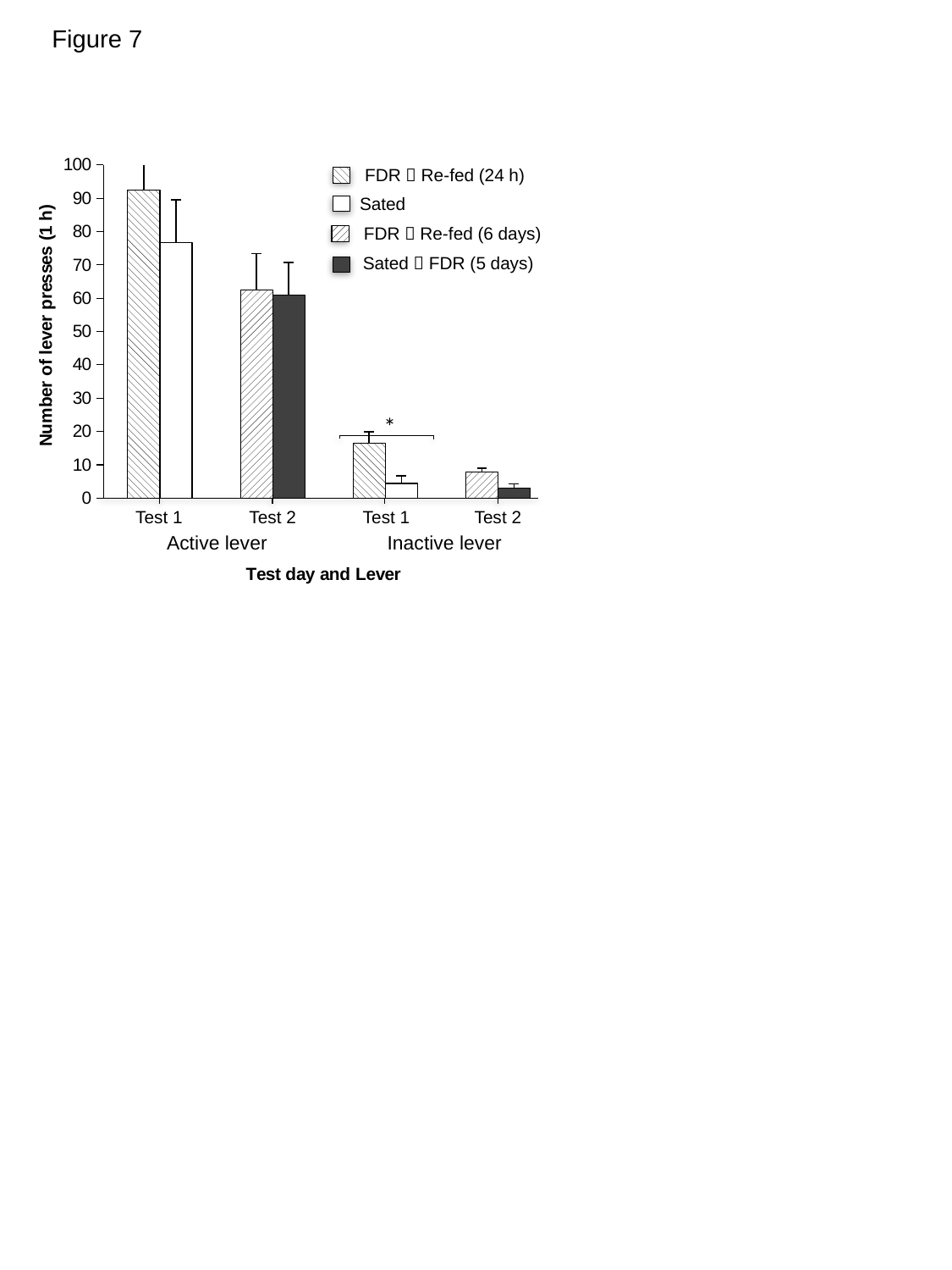
Is the value for Sated on the Active lever at Test 1 greater or less than 70? greater Is the value for FDR → Re-fed (24 h) on the Active lever at Test 1 greater or less than 80? greater What kind of chart is shown on the slide? bar chart What is the title of the x axis? Test day and Lever Is the value for FDR → Re-fed (24 h) on the Inactive lever at Test 1 greater or less than 20? less How many series does the legend list? 4 What is the title of the y axis? Number of lever presses (1 h) How many category groups are shown along the x axis? 4 Which bar is the highest in the chart? FDR → Re-fed (24 h), Active lever Test 1 On the Active lever at Test 1, which is larger: FDR → Re-fed (24 h) or Sated? FDR → Re-fed (24 h)